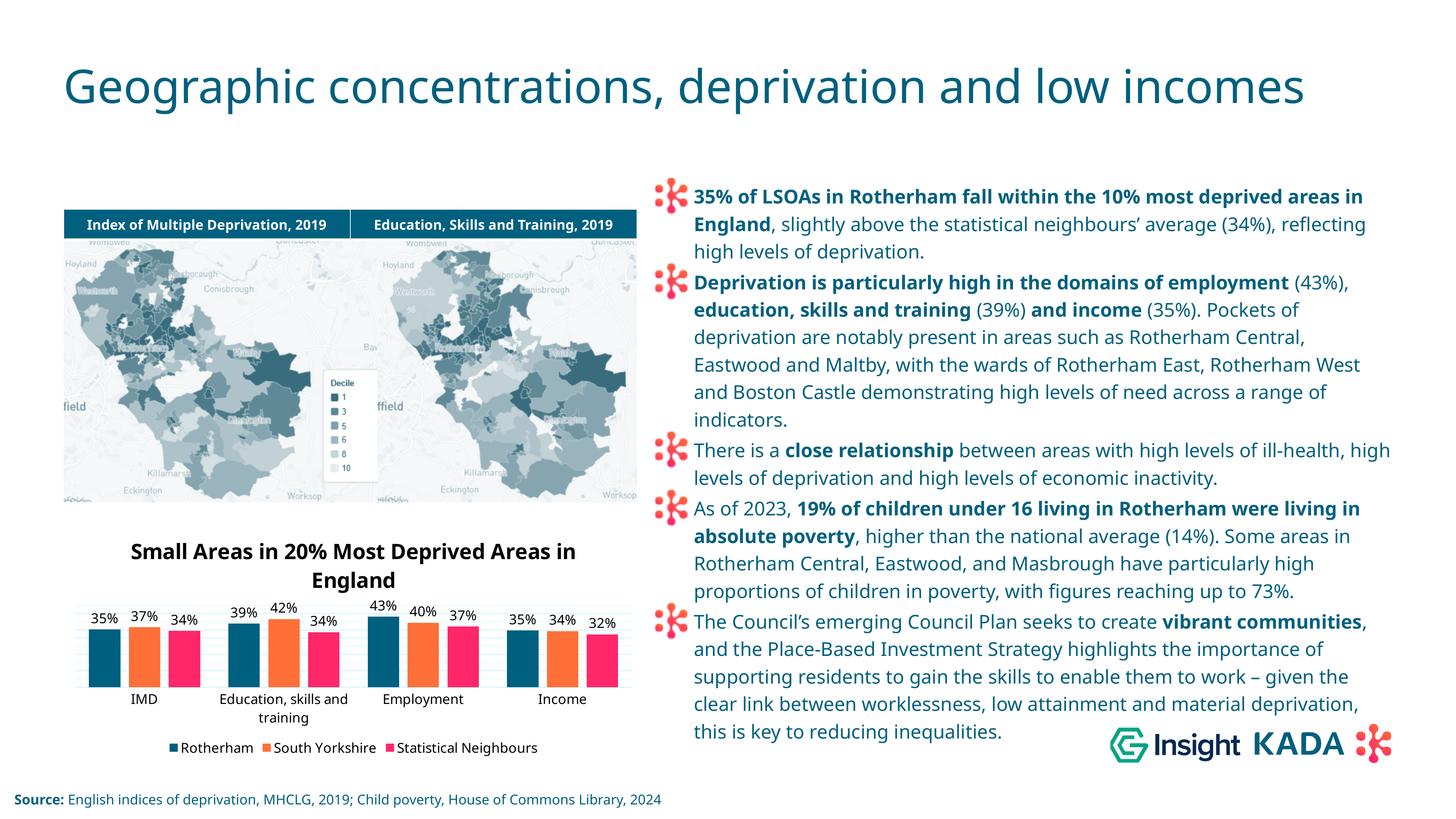
How many series does the legend of the chart 'Small Areas in 20% Most Deprived Areas in England' list? 3 What kind of chart is 'Small Areas in 20% Most Deprived Areas in England'? Bar chart In the chart 'Small Areas in 20% Most Deprived Areas in England', in which category does Statistical Neighbours have its lowest value? Income In the chart 'Small Areas in 20% Most Deprived Areas in England', in which category does Rotherham have its highest value? Employment In the chart 'Small Areas in 20% Most Deprived Areas in England', what is the value for South Yorkshire in the IMD category? 37% In the chart 'Small Areas in 20% Most Deprived Areas in England', what is the difference between the Rotherham and Statistical Neighbours values for Employment? 6% In the chart 'Small Areas in 20% Most Deprived Areas in England', what is the value for Rotherham in the Employment category? 43% In the chart 'Small Areas in 20% Most Deprived Areas in England', what is the value for South Yorkshire in the Education, skills and training category? 42% In the chart 'Small Areas in 20% Most Deprived Areas in England', which is larger for Education, skills and training: Rotherham or South Yorkshire? South Yorkshire In the chart 'Small Areas in 20% Most Deprived Areas in England', which series is shown in orange? South Yorkshire How many categories are shown on the x axis of the chart 'Small Areas in 20% Most Deprived Areas in England'? 4 In the chart 'Small Areas in 20% Most Deprived Areas in England', what is the value for Statistical Neighbours in the Income category? 32%